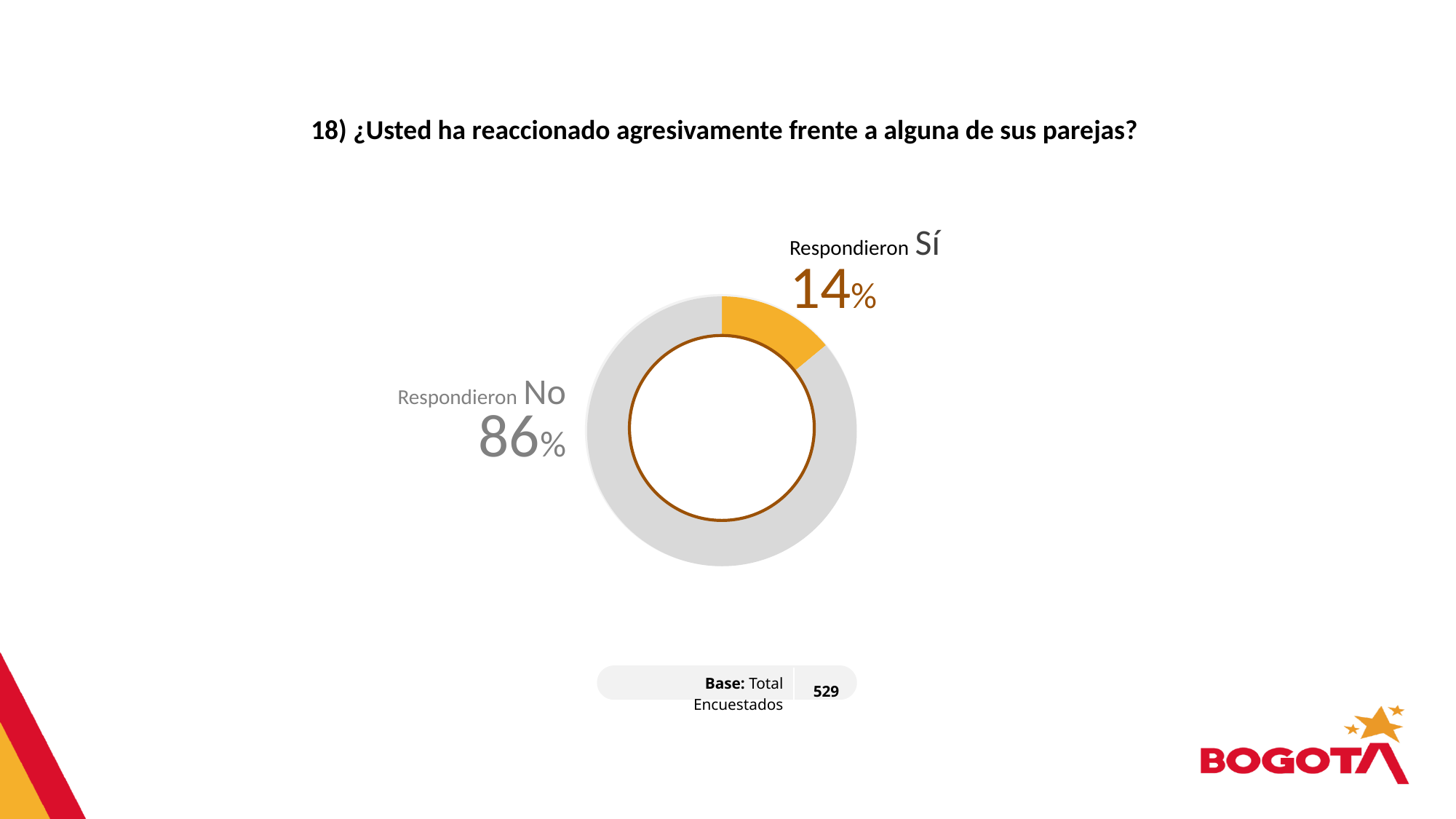
What percentage of respondents answered "No"? 86% What kind of chart is shown on the slide? Doughnut chart Which response has the smallest share of the chart? Sí What percentage of respondents answered "Sí"? 14% Which response has the larger share, "Sí" or "No"? No What is the total number of respondents (base) shown on the slide? 529 What is the combined percentage of the "Sí" and "No" responses? 100% What question number is shown in the slide title? 18 What is the difference in percentage points between the "No" and "Sí" responses? 72 How many response categories does the chart show? 2 What colour represents the "Sí" response in the chart? Orange/yellow